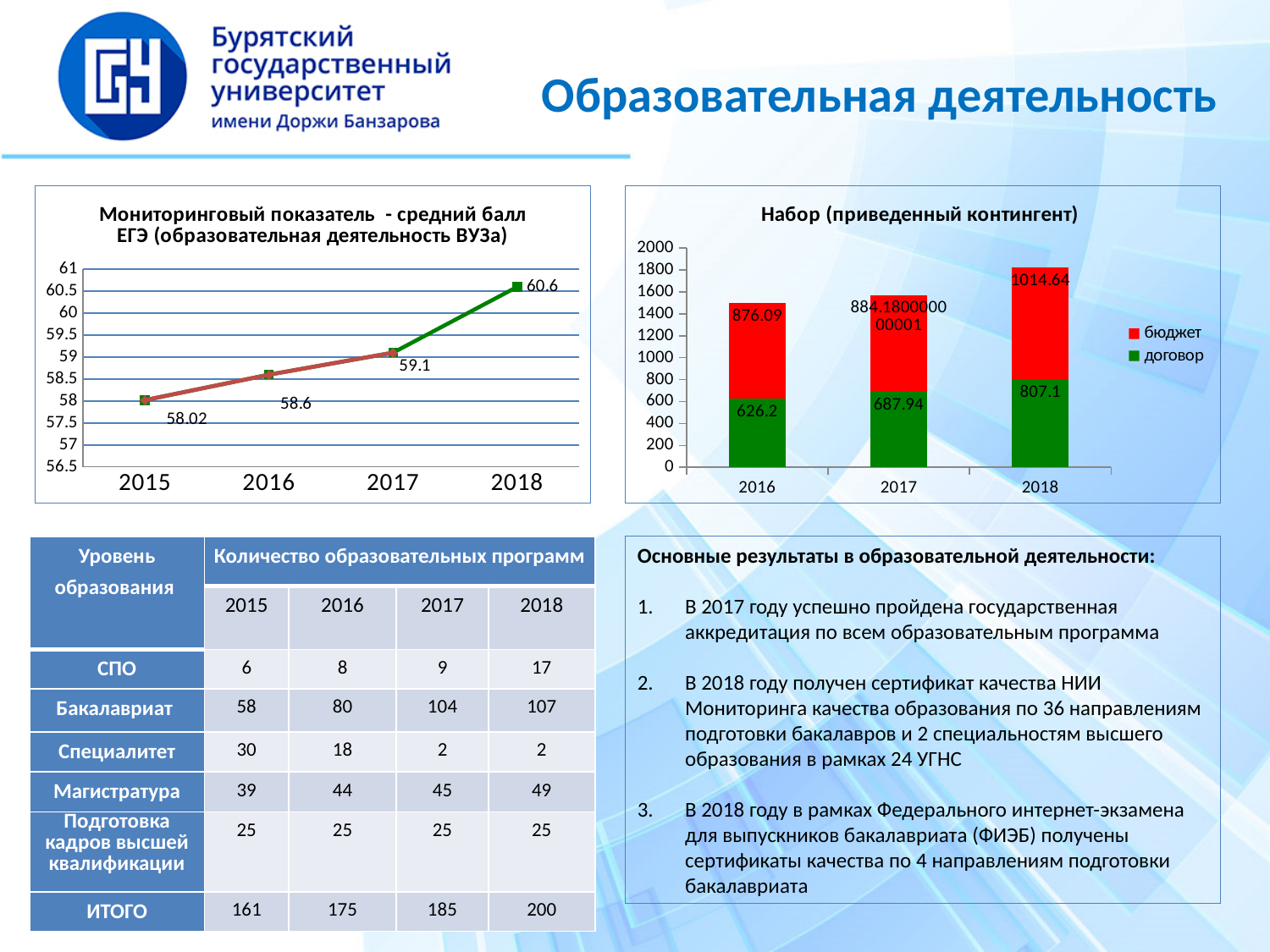
What kind of chart is 'Набор (приведенный контингент)'? stacked bar chart How many years are plotted in the chart 'Мониторинговый показатель - средний балл ЕГЭ'? 4 How many series does the legend of the chart 'Набор (приведенный контингент)' list? 2 In the chart 'Набор (приведенный контингент)', what is the value of 'бюджет' for 2018? 1014.64 In the chart 'Мониторинговый показатель - средний балл ЕГЭ', which year has the lowest value? 2015 In the chart 'Мониторинговый показатель - средний балл ЕГЭ', what is the value for 2015? 58.02 In the chart 'Мониторинговый показатель - средний балл ЕГЭ', what is the difference between the 2018 and 2017 values? 1.5 In the chart 'Мониторинговый показатель - средний балл ЕГЭ', what is the value for 2018? 60.6 In the chart 'Набор (приведенный контингент)', what is the total of the stacked bar for 2016? 1502.29 In the chart 'Набор (приведенный контингент)', what is the value of 'договор' for 2017? 687.94 In the chart 'Набор (приведенный контингент)', which year has the highest 'договор' value? 2018 In the chart 'Мониторинговый показатель - средний балл ЕГЭ', do the values rise or fall from 2015 to 2018? rise